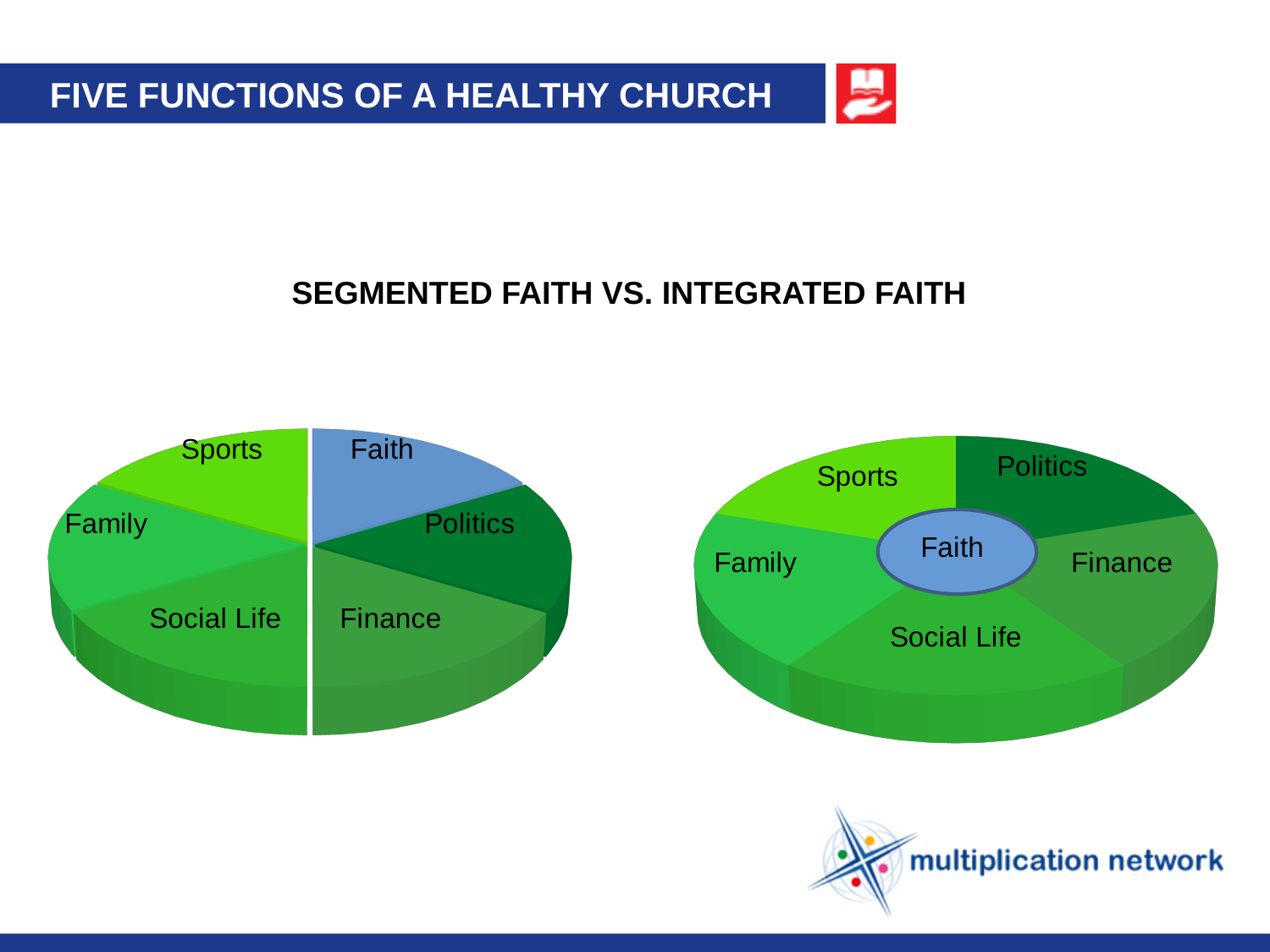
In the left pie chart, which slice sits between Faith and Finance? Politics How many slices does the right pie chart have around the central Faith circle? 5 What kind of chart is the left chart on the slide? pie chart What is the title shown above the two pie charts? SEGMENTED FAITH VS. INTEGRATED FAITH In the right pie chart, which slice sits between Finance and Family along the bottom? Social Life In the left pie chart, which slice is coloured blue? Faith In the right pie chart, which label appears in the circle at the centre of the pie? Faith How many slices does the left pie chart have? 6 Which slice label appears in the left pie chart but not as a slice in the right pie chart? Faith What kind of chart is the right chart on the slide? pie chart